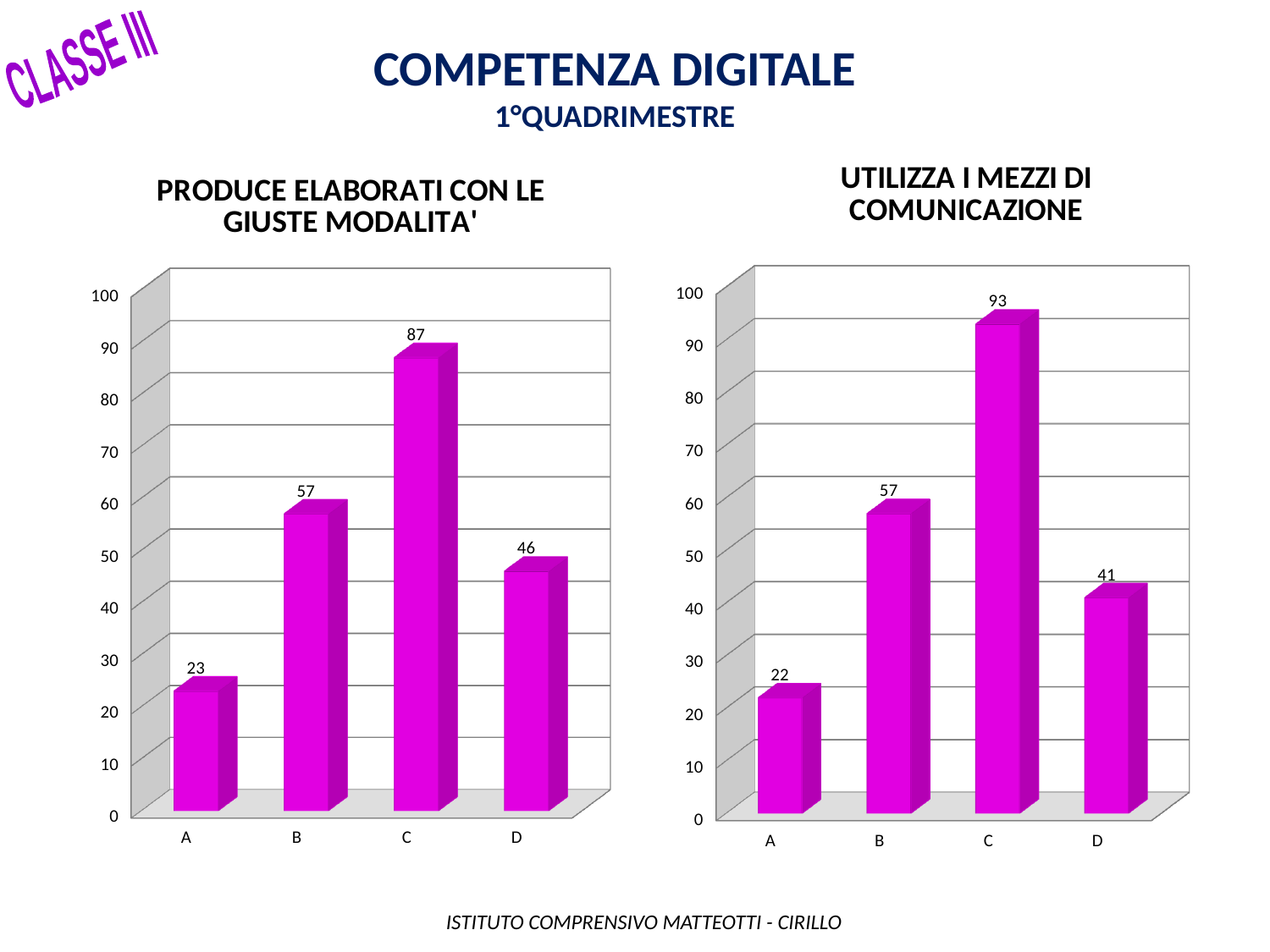
In the chart titled "PRODUCE ELABORATI CON LE GIUSTE MODALITA'", which is larger, the value for B or the value for D? B In the chart titled "UTILIZZA I MEZZI DI COMUNICAZIONE", what is the value for category A? 22 In the chart titled "UTILIZZA I MEZZI DI COMUNICAZIONE", what is the difference between the values for B and D? 16 In the chart titled "UTILIZZA I MEZZI DI COMUNICAZIONE", which category has the highest value? C In the chart titled "PRODUCE ELABORATI CON LE GIUSTE MODALITA'", what is the value for category C? 87 In the chart titled "UTILIZZA I MEZZI DI COMUNICAZIONE", what is the value for category D? 41 In the chart titled "PRODUCE ELABORATI CON LE GIUSTE MODALITA'", what is the difference between the values for C and B? 30 In the chart titled "UTILIZZA I MEZZI DI COMUNICAZIONE", is the value for D greater or less than 50? less What kind of chart is the chart titled "UTILIZZA I MEZZI DI COMUNICAZIONE"? bar chart In the chart titled "PRODUCE ELABORATI CON LE GIUSTE MODALITA'", which category has the lowest value? A What is the title of the chart on the left of the slide? PRODUCE ELABORATI CON LE GIUSTE MODALITA' How many categories are shown in the chart titled "PRODUCE ELABORATI CON LE GIUSTE MODALITA'"? 4